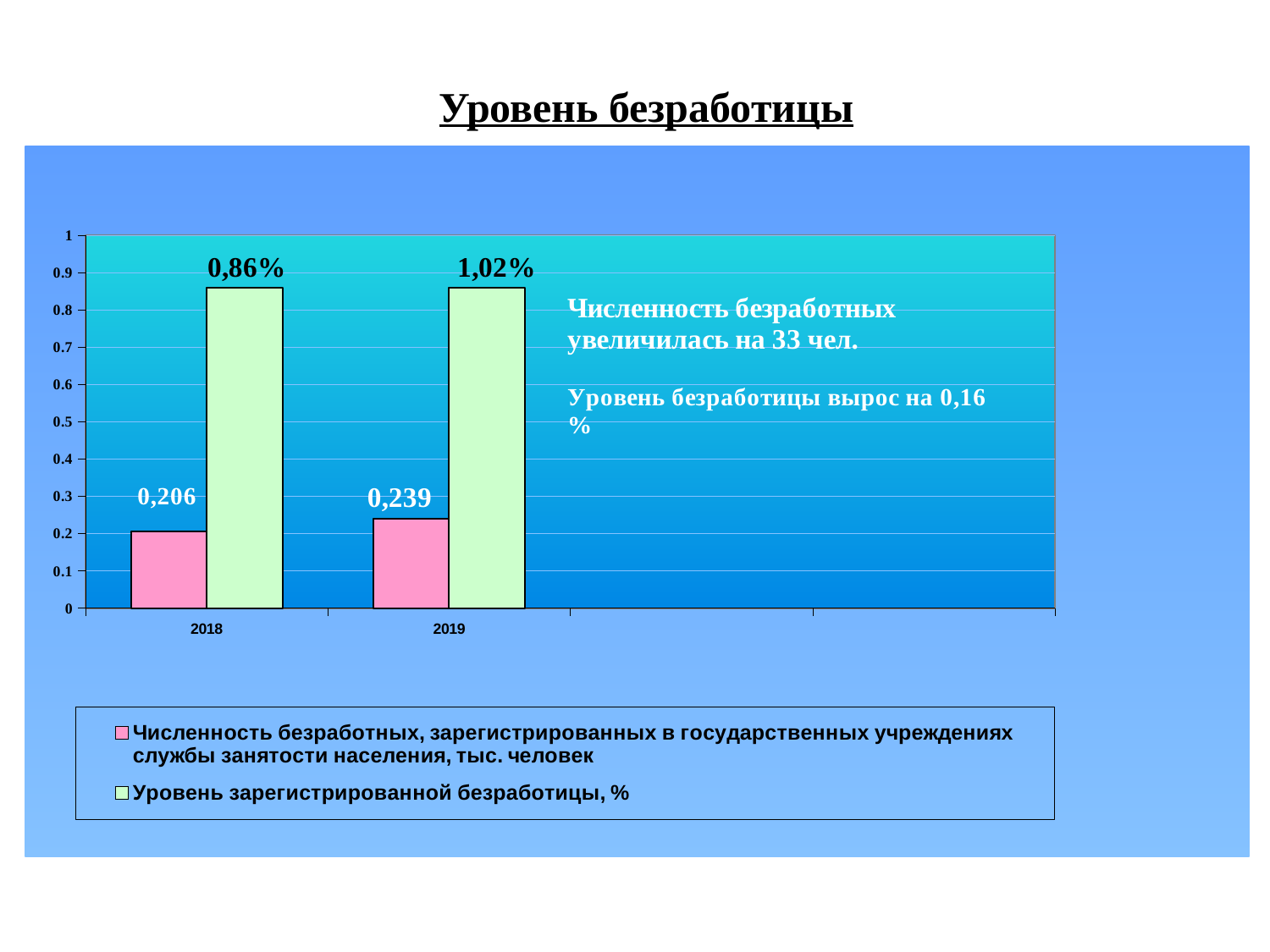
What type of chart is shown on the slide? Bar chart What is the difference between the 2019 and 2018 values of 'Численность безработных, зарегистрированных в государственных учреждениях службы занятости населения, тыс. человек'? 0,033 Which year has the larger value for 'Численность безработных, зарегистрированных в государственных учреждениях службы занятости населения, тыс. человек', 2018 or 2019? 2019 What is the value of the series 'Численность безработных, зарегистрированных в государственных учреждениях службы занятости населения, тыс. человек' for 2018? 0,206 What is the value of the series 'Уровень зарегистрированной безработицы, %' for 2019? 1,02% What is the title of the slide? Уровень безработицы What is the value of the series 'Численность безработных, зарегистрированных в государственных учреждениях службы занятости населения, тыс. человек' for 2019? 0,239 What is the value of the series 'Уровень зарегистрированной безработицы, %' for 2018? 0,86% Is the 2018 value for 'Численность безработных, зарегистрированных в государственных учреждениях службы занятости населения, тыс. человек' greater or less than 0.3? less How many series does the chart legend list? 2 By how much did the value of 'Уровень зарегистрированной безработицы, %' change from 2018 to 2019? 0,16% How many years (categories) are shown on the x axis of the chart? 2